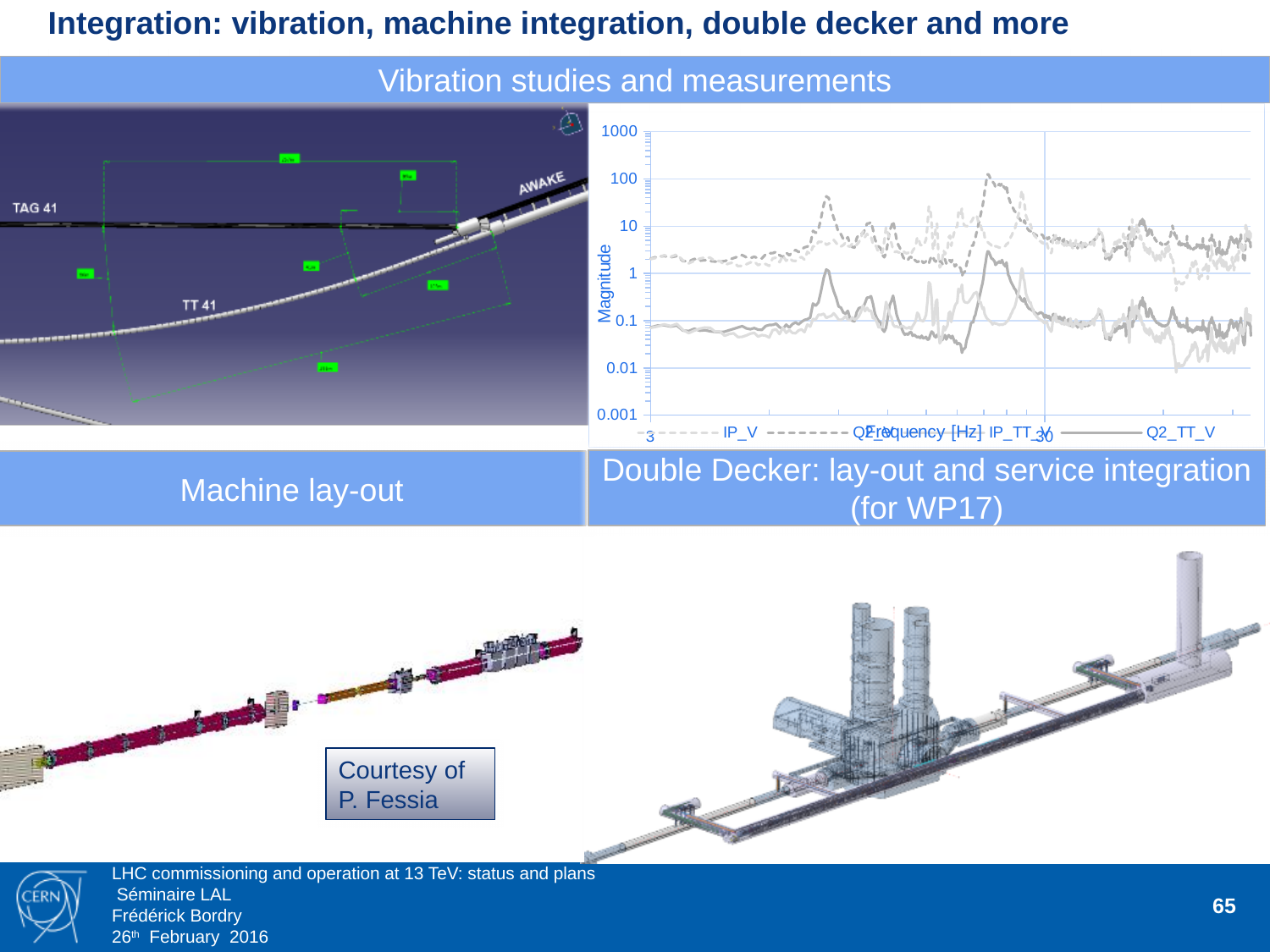
How many series does the legend of the vibration chart list? 4 What kind of chart is shown in the 'Vibration studies and measurements' section? line chart Which series is listed last in the legend of the vibration chart? Q2_TT_V What is the lowest tick value shown on the y-axis of the vibration chart? 0.001 What is the label of the y-axis on the vibration chart? Magnitude Which series is listed first in the legend of the vibration chart? IP_V What is the highest tick value shown on the y-axis of the vibration chart? 1000 What is the label of the x-axis on the vibration chart? Frequency [Hz] How many labelled tick values are shown on the y-axis of the vibration chart? 7